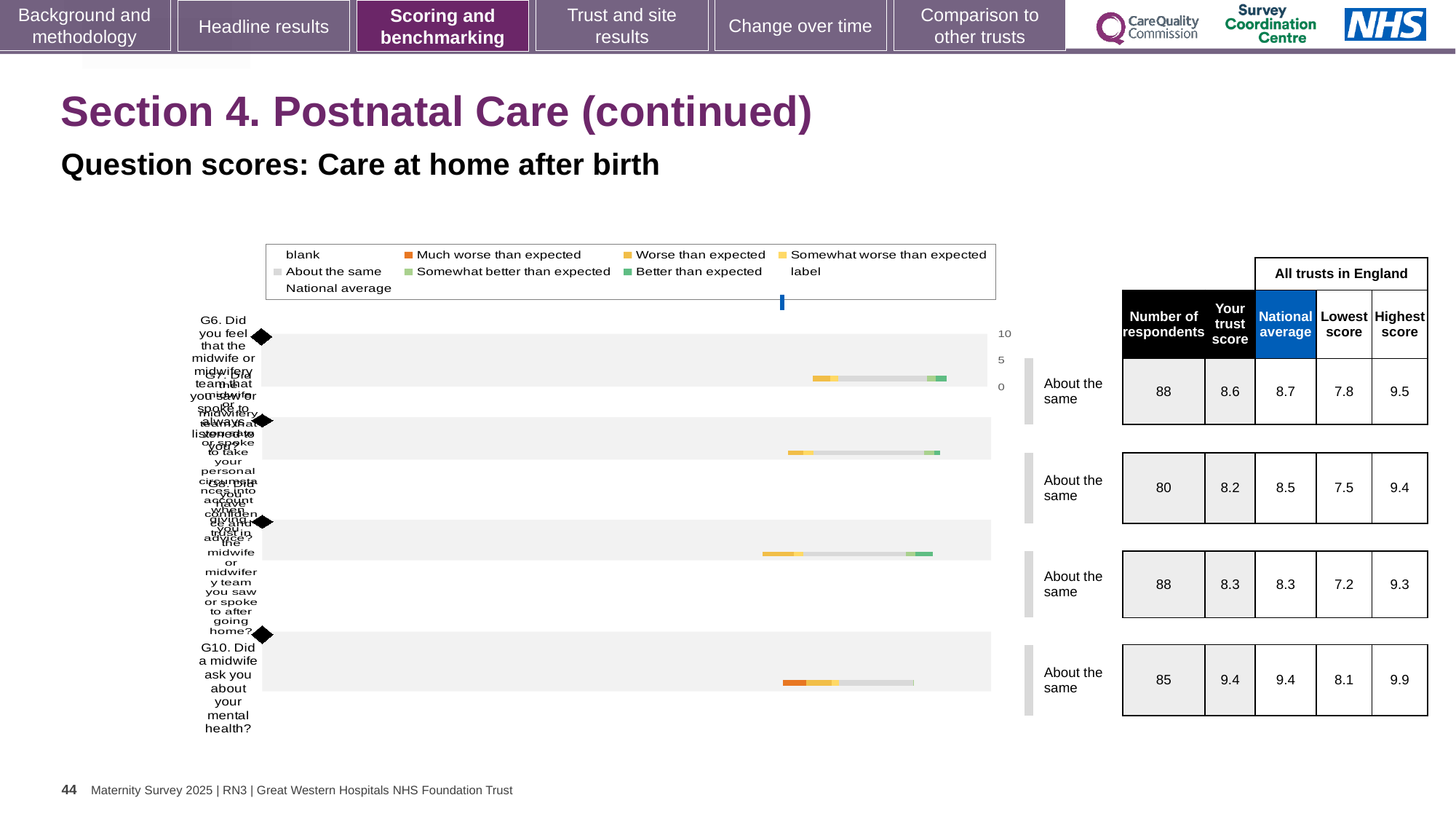
What kind of chart is shown on the slide? bar chart What is the title of the chart section on the slide? Question scores: Care at home after birth What is the number of respondents for G10 (Did a midwife ask you about your mental health?)? 85 What is the highest score among all trusts in England for G10 (Did a midwife ask you about your mental health?)? 9.9 Which question row has the highest trust score? G10. Did a midwife ask you about your mental health? What benchmark category is shown for G10 (Did a midwife ask you about your mental health?)? About the same What is the trust score for G10 (Did a midwife ask you about your mental health?)? 9.4 What is the national average for G10 (Did a midwife ask you about your mental health?)? 9.4 What is the difference between the highest score and the lowest score for G10 (Did a midwife ask you about your mental health?)? 1.8 How many question rows (bars) are plotted in the chart? 4 Which legend entry is shown in orange? Much worse than expected What is the lowest score among all trusts in England for G10 (Did a midwife ask you about your mental health?)? 8.1